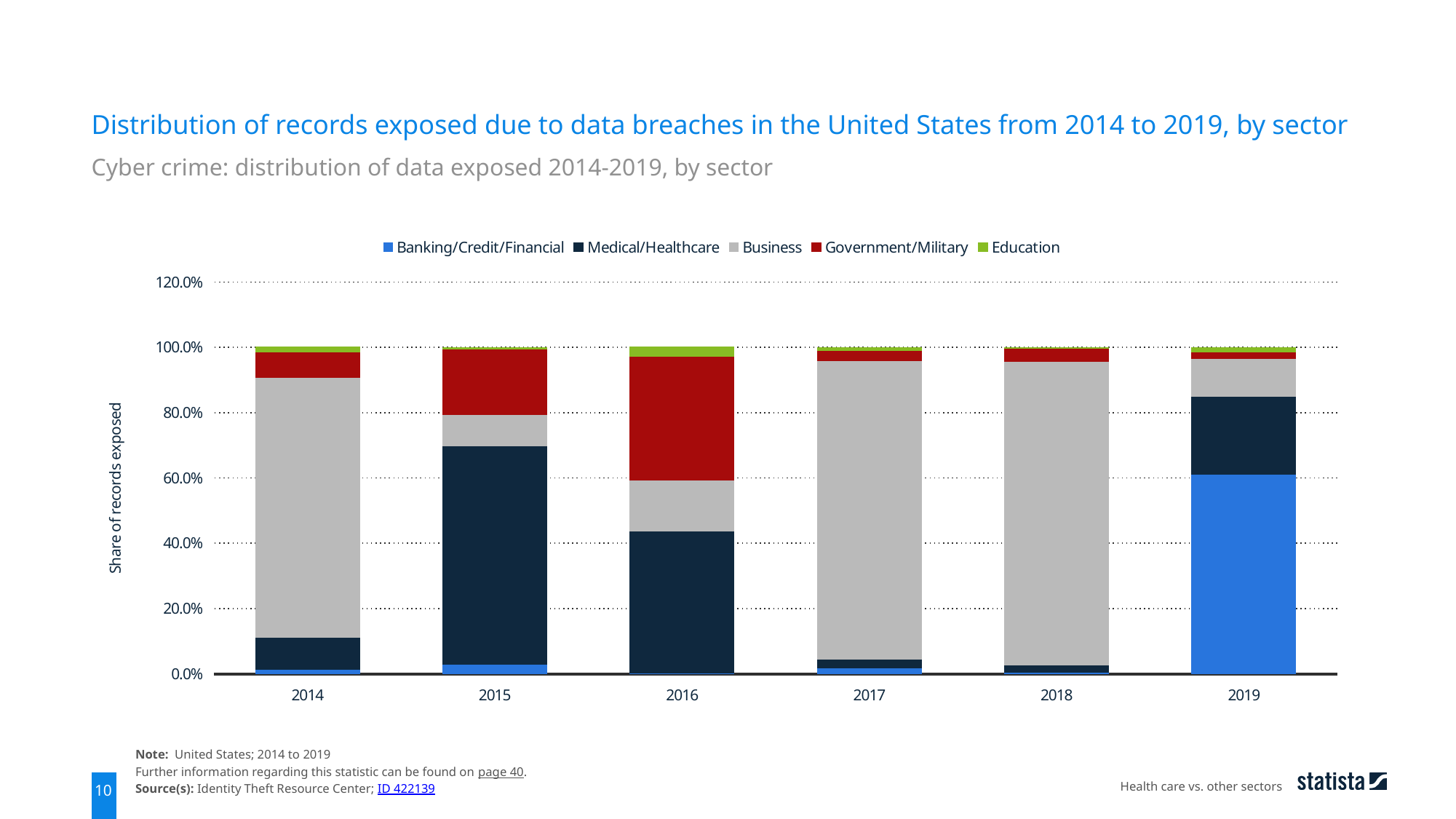
In which year is the Medical/Healthcare share of records exposed the largest? 2015 How many series does the legend list? 5 What is the title of the chart? Distribution of records exposed due to data breaches in the United States from 2014 to 2019, by sector In which year is the Banking/Credit/Financial share of records exposed the largest? 2019 Which colour represents the Education sector in the chart? Green In which year is the Government/Military share of records exposed the largest? 2016 Which year has a larger Medical/Healthcare share, 2015 or 2016? 2015 Which year has a larger Banking/Credit/Financial share, 2014 or 2019? 2019 How many years are shown on the x axis of the chart? 6 Is the Medical/Healthcare share in 2014 greater or less than 20%? less Is the Medical/Healthcare share in 2016 greater or less than 40%? greater What kind of chart is shown on the slide? Stacked bar chart